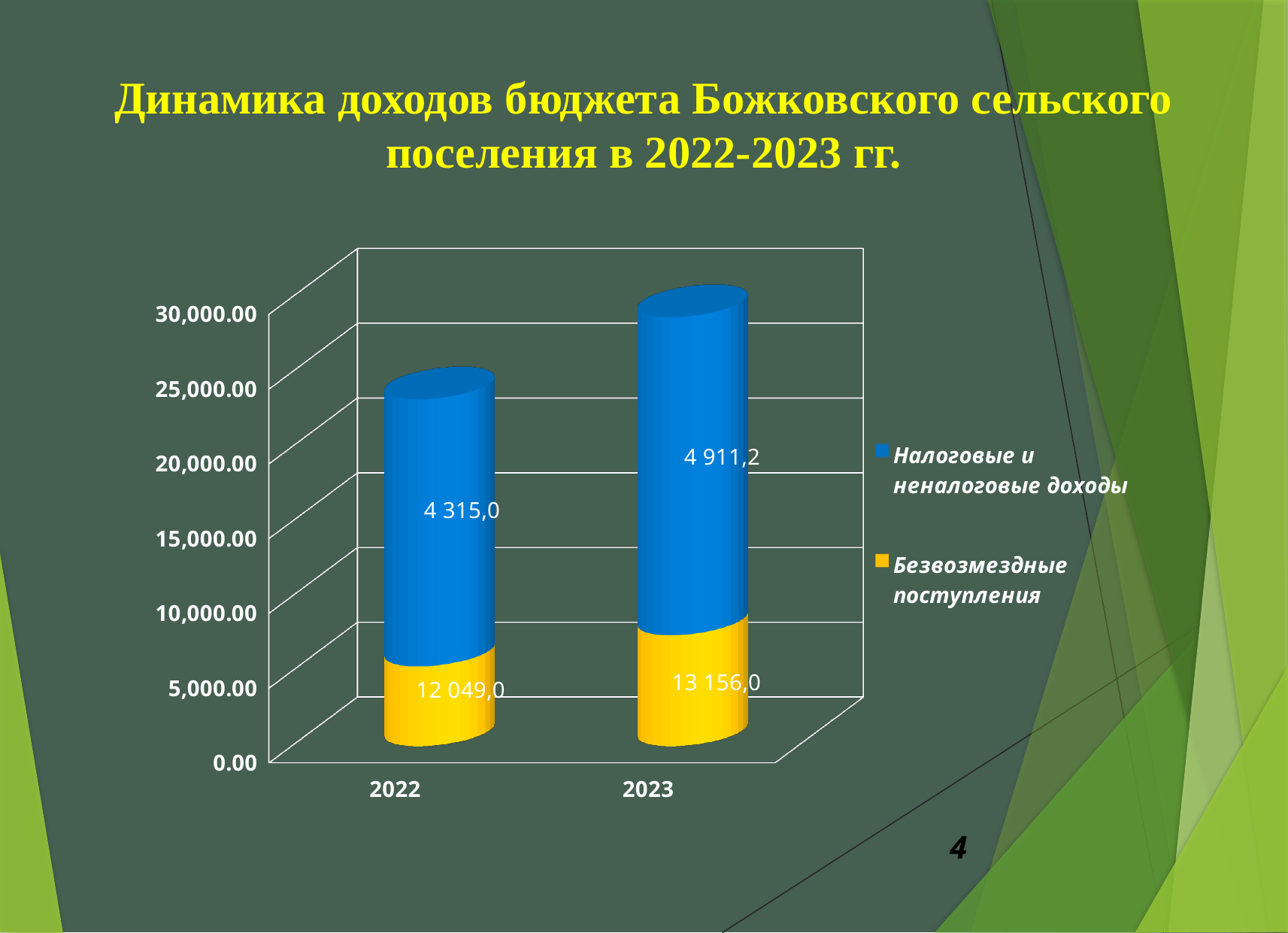
What value is printed on the blue segment (Налоговые и неналоговые доходы) for 2022? 4 315,0 Which year has the taller total bar, 2022 or 2023? 2023 What value is printed on the blue segment (Налоговые и неналоговые доходы) for 2023? 4 911,2 What value is printed on the yellow segment (Безвозмездные поступления) for 2022? 12 049,0 How many series does the legend list? 2 How many years (categories) are shown on the x axis? 2 Do the total bar heights rise or fall from 2022 to 2023? rise What type of chart is shown on the slide? Stacked bar chart Is the top of the 2023 bar greater or less than 25,000.00? greater By how much does the printed value on the blue segment (Налоговые и неналоговые доходы) change from 2022 to 2023? 596,2 What value is printed on the yellow segment (Безвозмездные поступления) for 2023? 13 156,0 By how much does the printed value on the yellow segment (Безвозмездные поступления) change from 2022 to 2023? 1 107,0